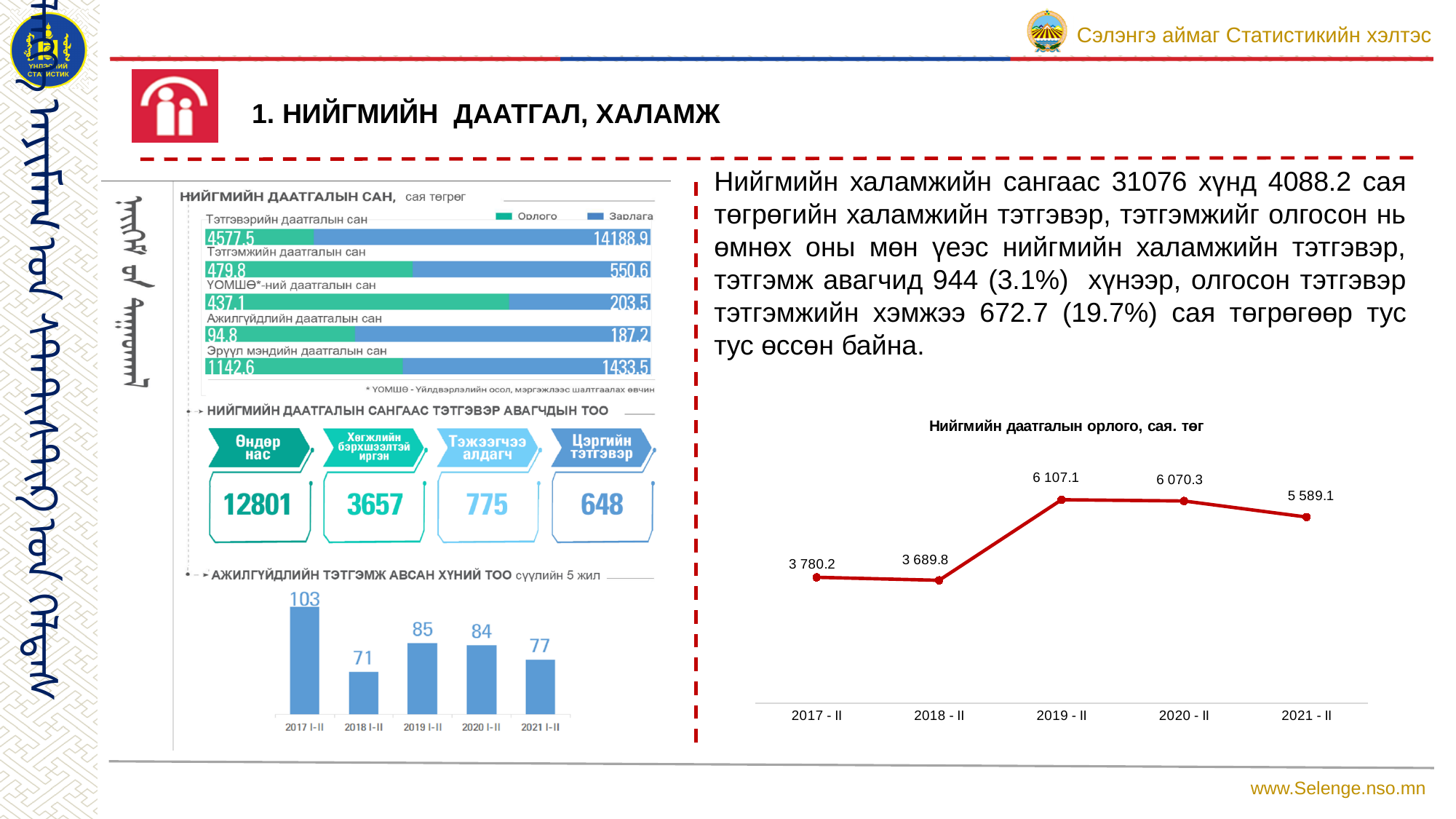
In the line chart titled 'Нийгмийн даатгалын орлого, сая. төг', which period has the lowest value? 2018 - II In the bar chart 'Ажилгүйдлийн тэтгэмж авсан хүний тоо' at the bottom left, which year has the lowest value? 2018 I-II In the bar chart 'Ажилгүйдлийн тэтгэмж авсан хүний тоо' at the bottom left, what is the value for 2017 I-II? 103 What kind of chart is 'Нийгмийн даатгалын орлого, сая. төг' on the right of the slide? line chart In the line chart titled 'Нийгмийн даатгалын орлого, сая. төг', what is the difference between the values for 2020 - II and 2021 - II? 481.2 In the bar chart 'Ажилгүйдлийн тэтгэмж авсан хүний тоо' at the bottom left, what is the difference between 2019 I-II and 2021 I-II? 8 In the line chart titled 'Нийгмийн даатгалын орлого, сая. төг', does the value rise or fall from 2019 - II to 2021 - II? fall In the 'Нийгмийн даатгалын сан' chart at the top left, how many series does the legend list? 2 In the line chart titled 'Нийгмийн даатгалын орлого, сая. төг', what is the value for 2019 - II? 6 107.1 In the line chart titled 'Нийгмийн даатгалын орлого, сая. төг', which period has the highest value? 2019 - II In the 'Нийгмийн даатгалын сан' chart at the top left, what is the Зарлага value for Тэтгэвэрийн даатгалын сан? 14188.9 In the line chart titled 'Нийгмийн даатгалын орлого, сая. төг', how many data points are plotted? 5